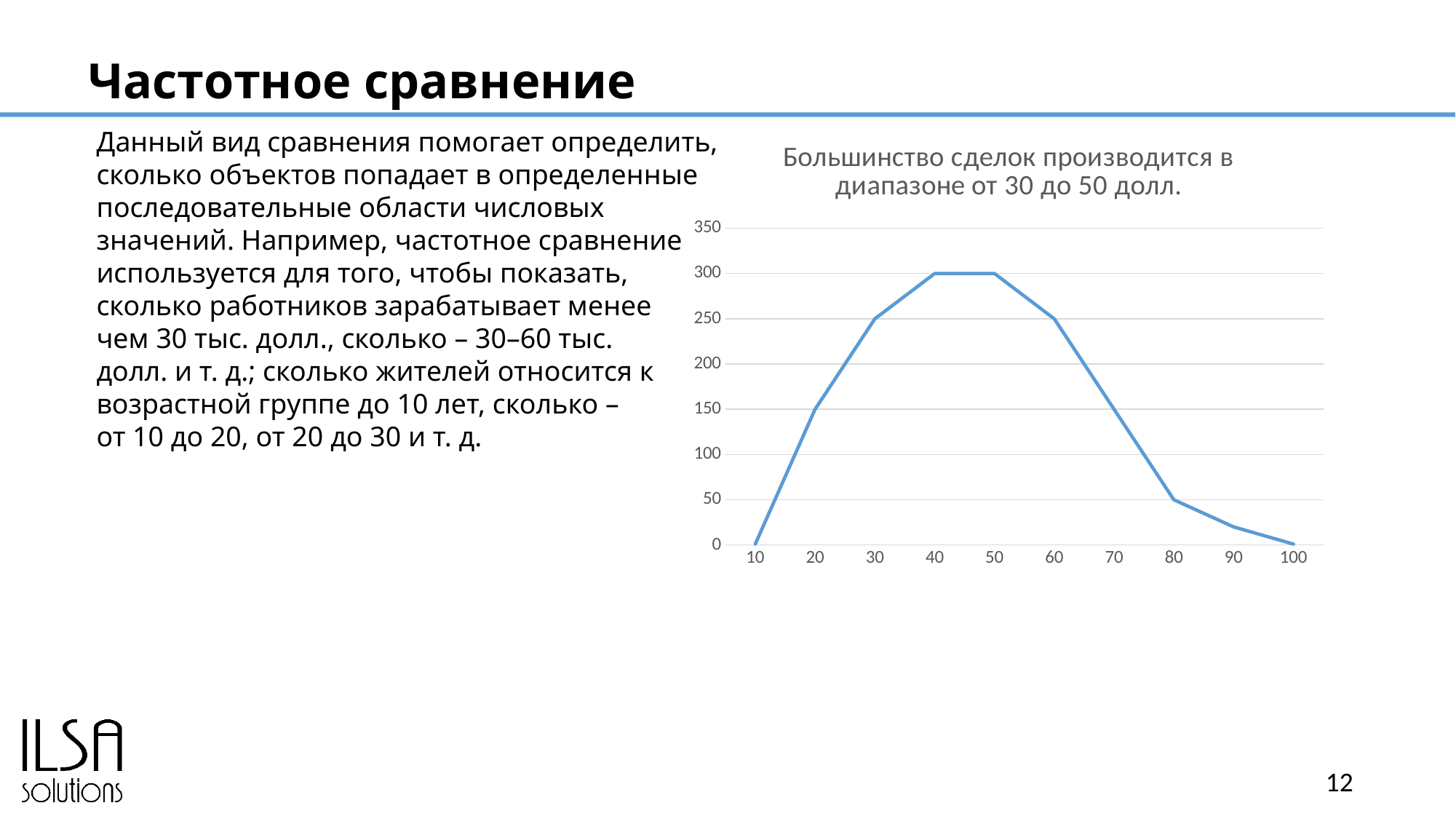
Is the value at x = 30 greater or less than 200? greater What is the value at x = 40? 300 What kind of chart is shown on the slide? line chart What is the value at x = 80? 50 What is the difference between the value at x = 40 and the value at x = 20? 150 What is the title of the chart? Большинство сделок производится в диапазоне от 30 до 50 долл. How many data points are plotted on the line? 10 Which is larger, the value at x = 30 or the value at x = 80? x = 30 What is the value at x = 20? 150 Is the value at x = 90 greater or less than 50? less What is the value at x = 60? 250 Do the values rise or fall along the x axis from 50 to 100? fall